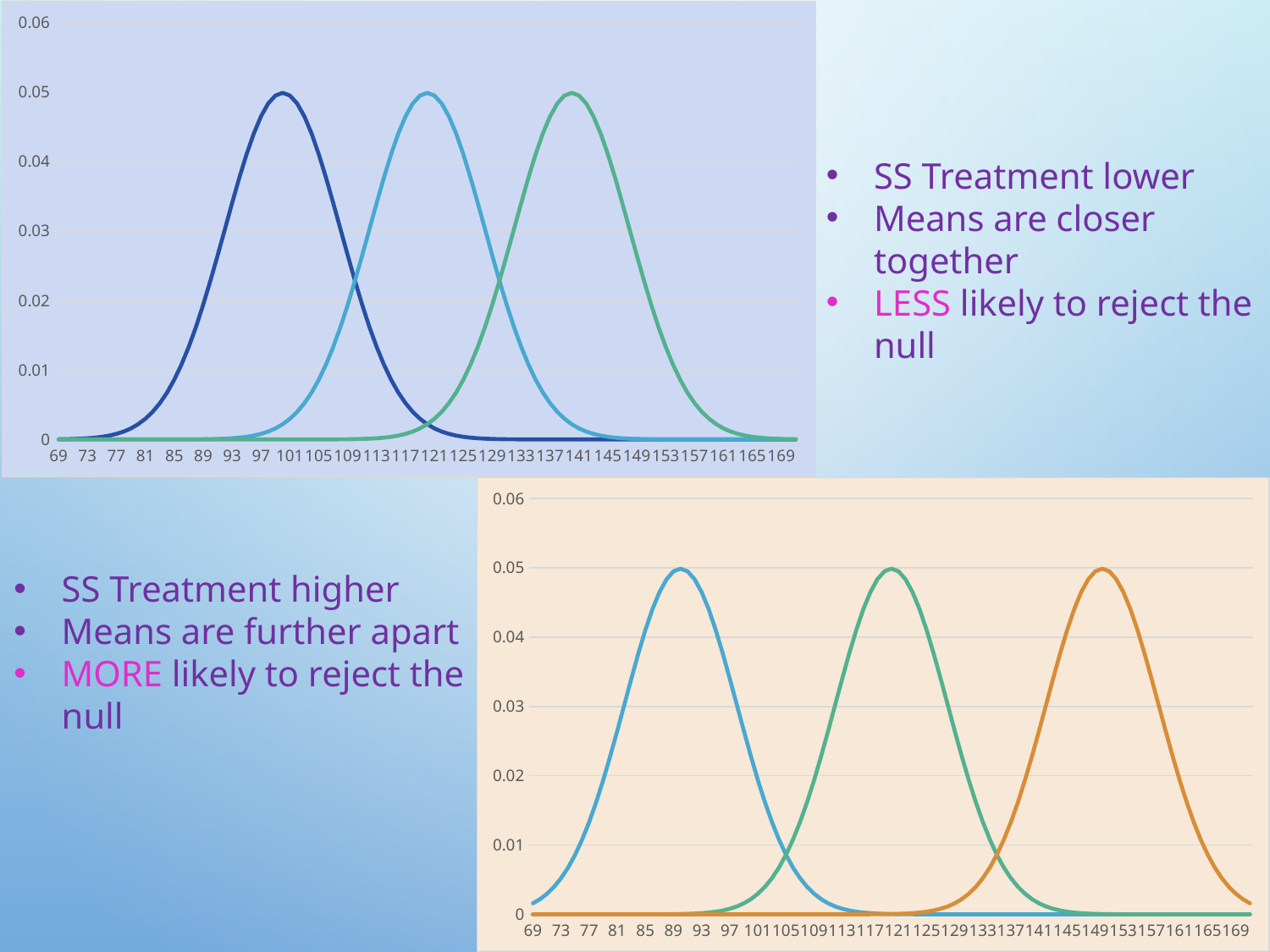
In the bottom chart, what is the peak value reached by each of the three curves? 0.05 What kind of chart is the top chart on the slide? line chart In the top chart, what is the highest value shown on the vertical axis? 0.06 In the bottom chart, is the value of the orange curve at 121 greater or less than 0.01? less In the bottom chart, what is the first label on the horizontal axis? 69 How many curves are plotted in the top chart? 3 How many curves are plotted in the bottom chart? 3 In the bottom chart, is the value of the green curve at 121 greater or less than 0.04? greater In the top chart, what is the peak value reached by each of the three curves? 0.05 In the top chart, is the value of the dark blue curve at 101 greater or less than 0.04? greater What kind of chart is the bottom chart on the slide? line chart